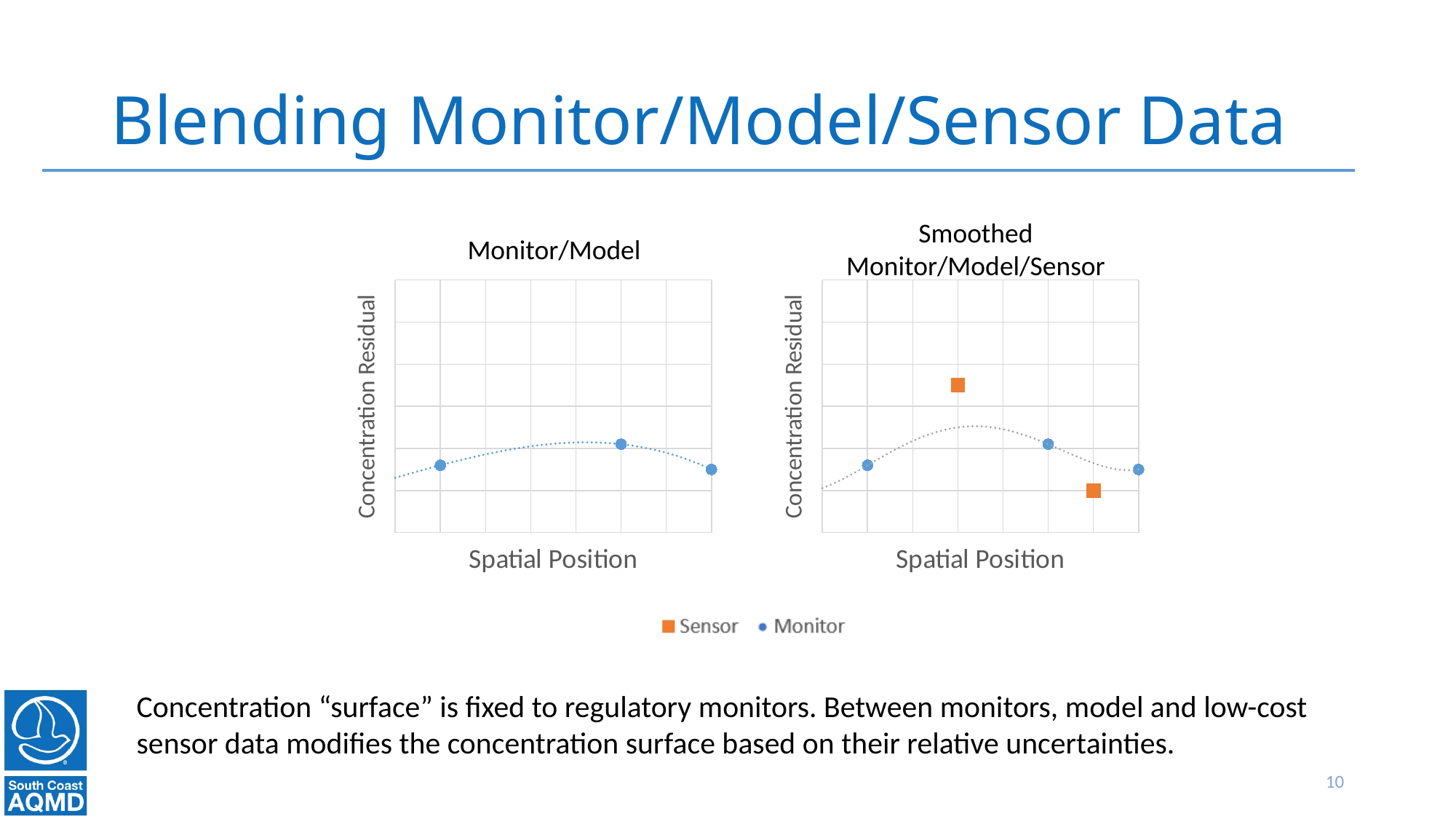
What are the two entries in the legend below the charts? Sensor and Monitor In the "Smoothed Monitor/Model/Sensor" chart on the right, is the left sensor point above or below all of the monitor points? above In the "Monitor/Model" chart on the left, which of the three monitor points has the lowest concentration residual: the leftmost, the middle, or the rightmost? rightmost What is the x-axis label on both charts? Spatial Position In the "Smoothed Monitor/Model/Sensor" chart on the right, how many monitor points are plotted? 3 In the "Monitor/Model" chart on the left, which of the three monitor points has the highest concentration residual: the leftmost, the middle, or the rightmost? middle What kind of chart is the "Monitor/Model" chart on the left? scatter chart In the "Smoothed Monitor/Model/Sensor" chart on the right, which sensor point has the higher concentration residual, the left one or the right one? left In the "Smoothed Monitor/Model/Sensor" chart on the right, how many sensor points are plotted? 2 In the "Smoothed Monitor/Model/Sensor" chart on the right, which point has the lowest concentration residual of all plotted points? the right sensor point In the "Monitor/Model" chart on the left, how many monitor points are plotted? 3 How many series does the legend below the charts list? 2